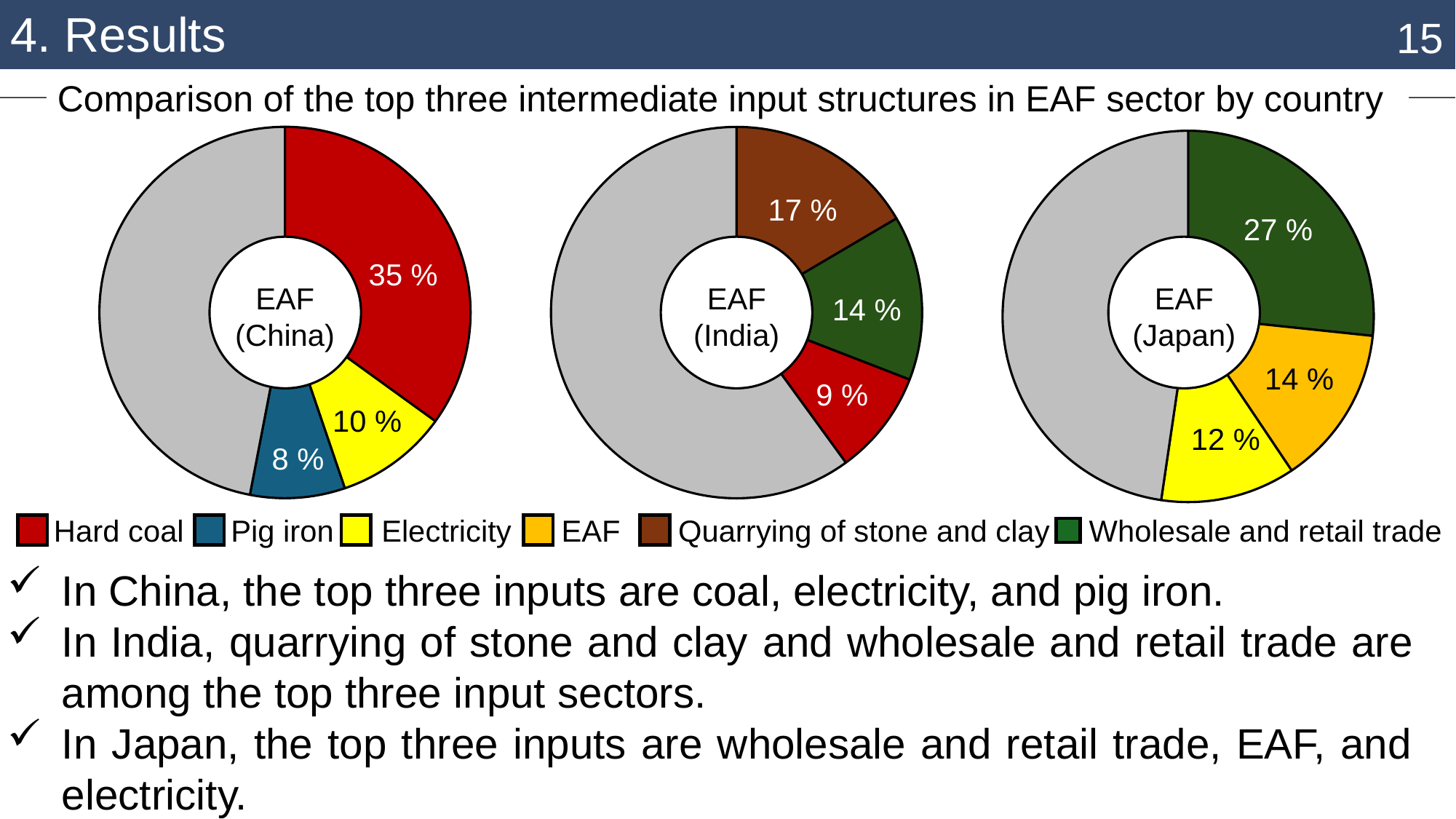
In the EAF (Japan) chart, what share is labelled for Wholesale and retail trade? 27 % What type of chart is used for each country on this slide? Donut (pie) chart How many input sectors are listed in the legend? 6 In the EAF (China) chart, what share is labelled for Pig iron? 8 % In the EAF (India) chart, which labelled input sector has the smallest share? Hard coal In the EAF (Japan) chart, what share is labelled for EAF? 14 % In the EAF (Japan) chart, which is larger, the share for EAF or the share for Electricity? EAF In the EAF (China) chart, which labelled input sector has the largest share? Hard coal In the EAF (China) chart, what is the difference between the Hard coal share and the Electricity share? 25 % In the EAF (China) chart, what share is labelled for Hard coal? 35 % In the EAF (India) chart, what share is labelled for Quarrying of stone and clay? 17 % In the EAF (India) chart, what is the total of the three labelled shares? 40 %